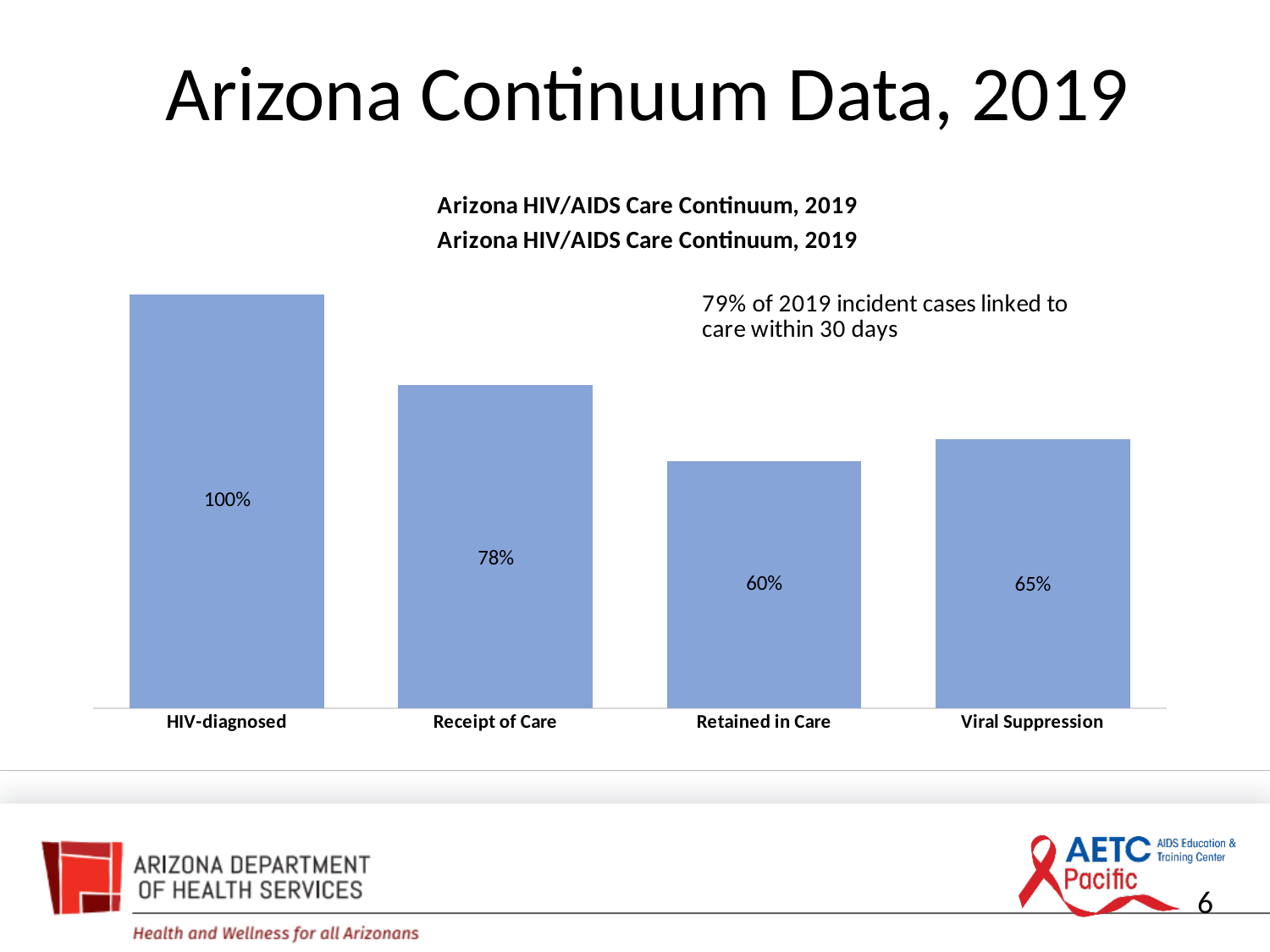
How many categories are shown in the chart? 4 Which is larger, the value for Viral Suppression or the value for Retained in Care? Viral Suppression What is the value for Receipt of Care? 78% Which category has the highest value? HIV-diagnosed Which category has the lowest value? Retained in Care What kind of chart is shown on the slide? Bar chart What is the title of the chart? Arizona HIV/AIDS Care Continuum, 2019 What is the value for Retained in Care? 60% What is the difference between the values for HIV-diagnosed and Viral Suppression? 35% What is the value for Viral Suppression? 65% What is the difference between the values for Receipt of Care and Retained in Care? 18% What is the value for HIV-diagnosed? 100%